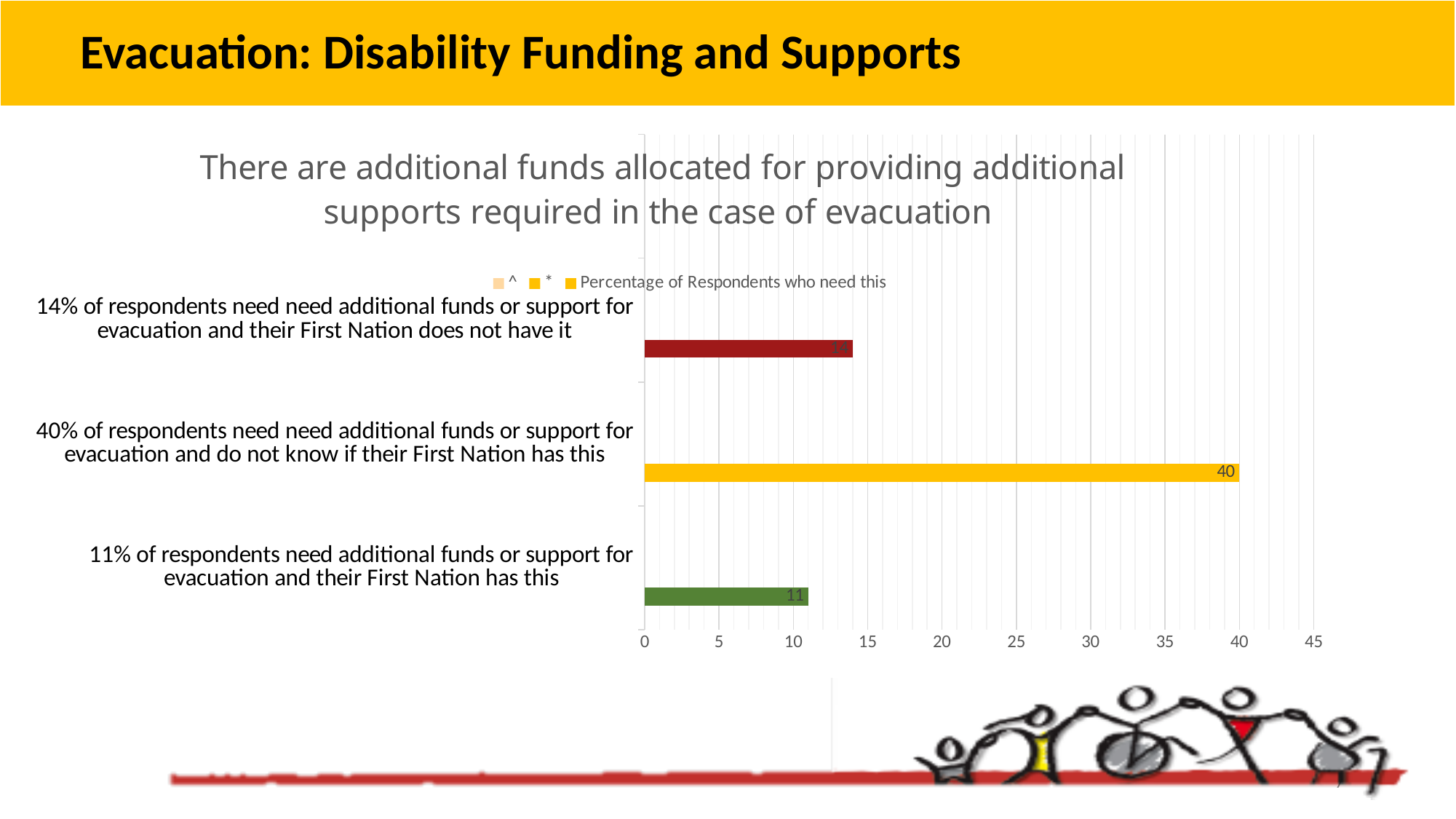
What is the title of the chart? There are additional funds allocated for providing additional supports required in the case of evacuation What type of chart is shown on the slide? Bar chart Which category has the lowest value in the chart? 11% of respondents need additional funds or support for evacuation and their First Nation has this Which is larger: the value for respondents whose First Nation does not have it, or the value for respondents whose First Nation has it? Respondents whose First Nation does not have it Which category has the highest value in the chart? 40% of respondents need need additional funds or support for evacuation and do not know if their First Nation has this What is the difference between the value for respondents who do not know if their First Nation has this and the value for respondents whose First Nation does not have it? 26 What is the difference between the value for respondents whose First Nation does not have it and the value for respondents whose First Nation has it? 3 What is the value of the bar for respondents who do not know if their First Nation has additional funds or support for evacuation? 40 What is the value of the bar for respondents whose First Nation has additional funds or support for evacuation? 11 Is the value for respondents who do not know if their First Nation has this greater or less than 35? greater How many categories are plotted in the chart? 3 What is the value of the bar for respondents whose First Nation does not have additional funds or support for evacuation? 14